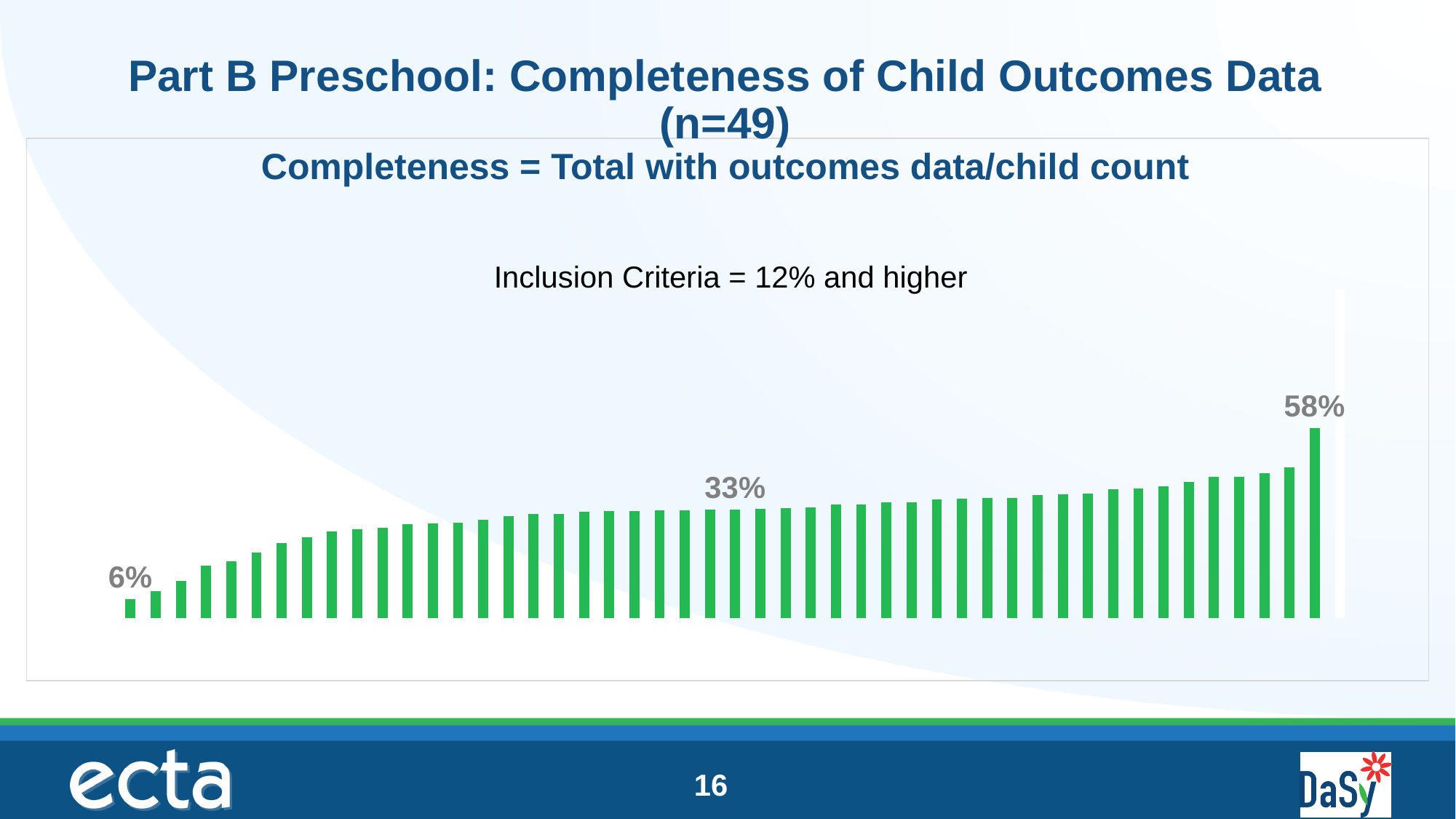
What value is labelled on the middle bar of the chart? 33% Do the bar values rise or fall from left to right across the chart? rise What kind of chart is shown on the slide? bar chart How many bars carry a printed data label? 3 How many bars (states/entities) are plotted in the chart, according to the n given in the slide title? 49 Which is larger, the first bar on the left or the last bar on the right? the last bar on the right What is the lowest value labelled on the chart? 6% What is the highest value labelled on the chart? 58% What is the title of the chart? Completeness = Total with outcomes data/child count What inclusion criteria is stated on the chart? 12% and higher What is the difference between the 58% bar and the 33% bar? 25 percentage points What is the difference between the highest labelled value (58%) and the lowest labelled value (6%)? 52 percentage points